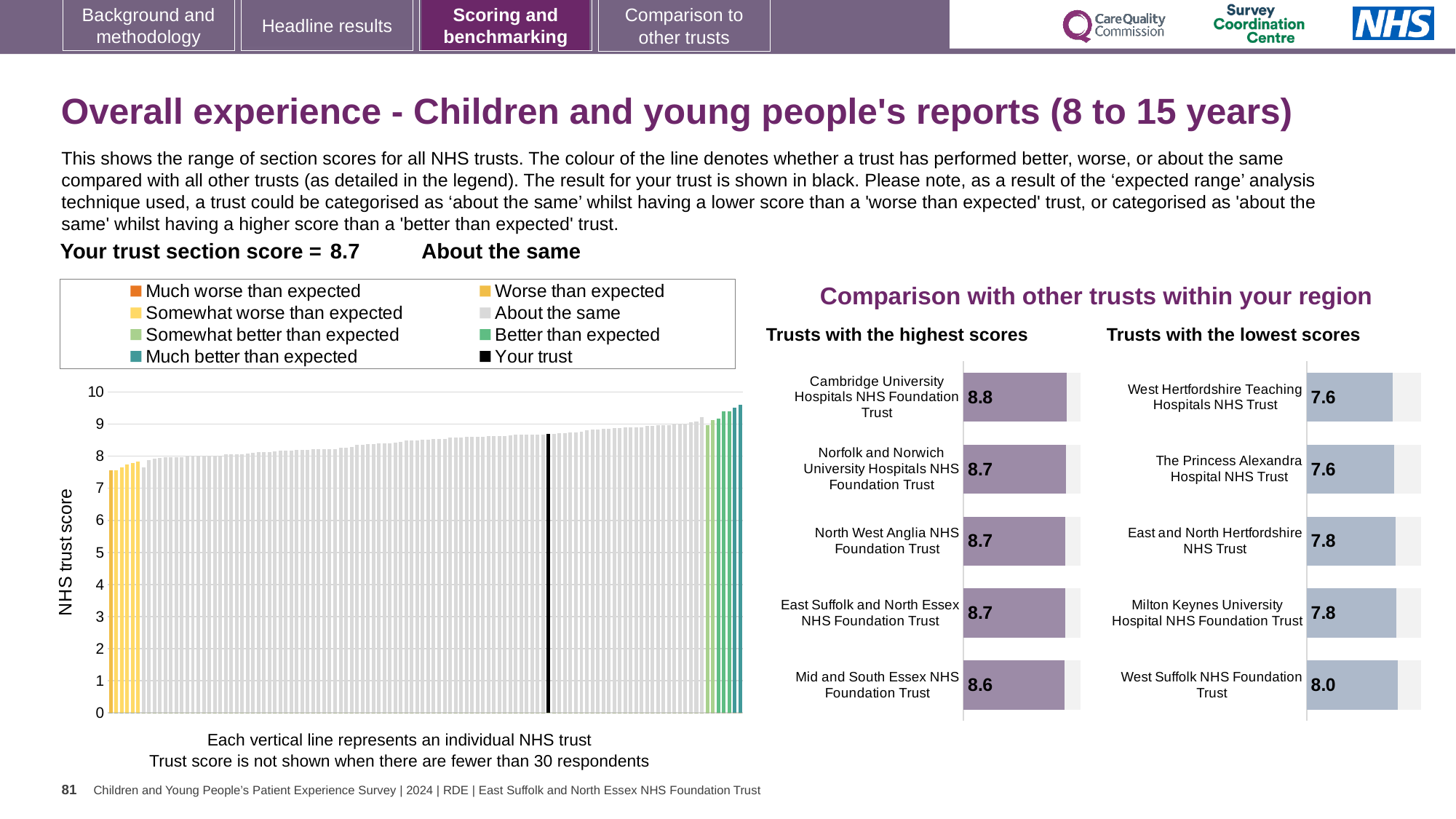
In the 'Trusts with the lowest scores' chart, what is the score for Milton Keynes University Hospital NHS Foundation Trust? 7.8 In the 'Trusts with the lowest scores' chart, which trust has the highest score? West Suffolk NHS Foundation Trust What kind of chart is the large chart on the left showing NHS trust scores? Bar chart In the 'Trusts with the highest scores' chart, what is the score for Mid and South Essex NHS Foundation Trust? 8.6 How many entries does the legend of the large chart on the left list? 8 In the 'Trusts with the highest scores' chart, what is the score for Cambridge University Hospitals NHS Foundation Trust? 8.8 In the 'Trusts with the lowest scores' chart, which has the larger score: East and North Hertfordshire NHS Trust or West Hertfordshire Teaching Hospitals NHS Trust? East and North Hertfordshire NHS Trust In the 'Trusts with the highest scores' chart, which trust has the highest score? Cambridge University Hospitals NHS Foundation Trust In the 'Trusts with the highest scores' chart, how many trusts are listed? 5 In the 'Trusts with the lowest scores' chart, what is the score for West Suffolk NHS Foundation Trust? 8.0 In the 'Trusts with the highest scores' chart, what is the difference between the scores of Cambridge University Hospitals NHS Foundation Trust and Mid and South Essex NHS Foundation Trust? 0.2 In the 'Trusts with the lowest scores' chart, what is the difference between the scores of West Suffolk NHS Foundation Trust and The Princess Alexandra Hospital NHS Trust? 0.4